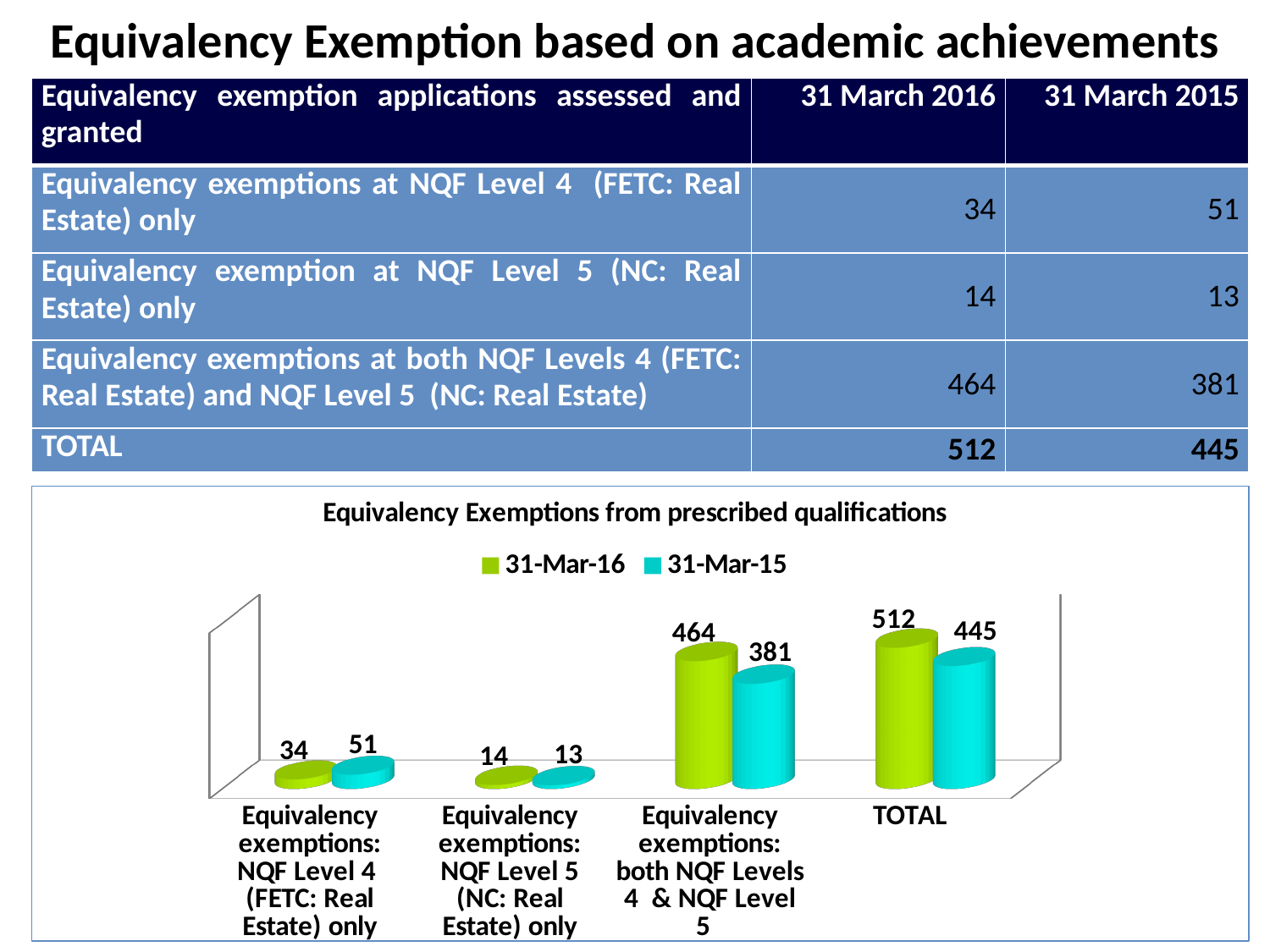
What is the difference between the TOTAL values for 31-Mar-16 and 31-Mar-15? 67 What is the value for 31-Mar-15 for Equivalency exemptions: both NQF Levels 4 & NQF Level 5? 381 What is the TOTAL value for 31-Mar-16? 512 How many categories are shown on the x axis of the chart? 4 Excluding TOTAL, which category has the highest value for 31-Mar-16? Equivalency exemptions: both NQF Levels 4 & NQF Level 5 What is the difference between the 31-Mar-16 and 31-Mar-15 values for Equivalency exemptions: both NQF Levels 4 & NQF Level 5? 83 What is the value for 31-Mar-16 for Equivalency exemptions: NQF Level 4 (FETC: Real Estate) only? 34 What is the value for 31-Mar-15 for Equivalency exemptions: NQF Level 5 (NC: Real Estate) only? 13 What is the title of the chart? Equivalency Exemptions from prescribed qualifications For Equivalency exemptions: NQF Level 4 (FETC: Real Estate) only, which series has the larger value, 31-Mar-16 or 31-Mar-15? 31-Mar-15 Which category has the lowest value for 31-Mar-15? Equivalency exemptions: NQF Level 5 (NC: Real Estate) only How many series does the chart legend list? 2